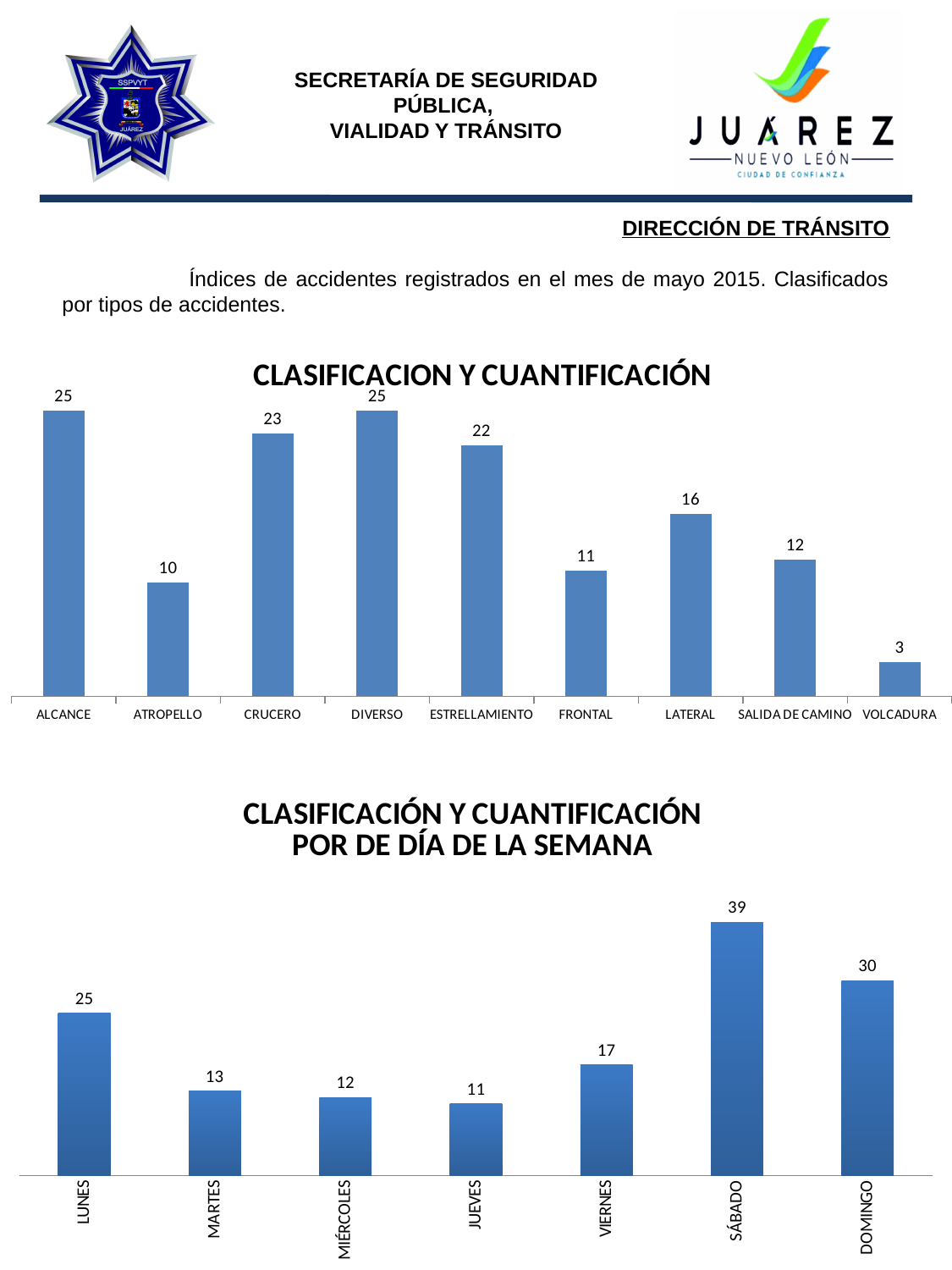
In the bottom chart (POR DE DÍA DE LA SEMANA), what is the difference between SÁBADO and DOMINGO? 9 In the bottom chart (POR DE DÍA DE LA SEMANA), what is the value for VIERNES? 17 In the bottom chart (POR DE DÍA DE LA SEMANA), which day has the lowest value? JUEVES How many categories are shown in the top chart (CLASIFICACION Y CUANTIFICACIÓN)? 9 In the top chart (CLASIFICACION Y CUANTIFICACIÓN), which category has the lowest value? VOLCADURA How many days are shown in the bottom chart (POR DE DÍA DE LA SEMANA)? 7 What type of chart is the bottom chart (POR DE DÍA DE LA SEMANA)? Bar chart In the top chart (CLASIFICACION Y CUANTIFICACIÓN), what is the value for LATERAL? 16 In the top chart (CLASIFICACION Y CUANTIFICACIÓN), what is the difference between ESTRELLAMIENTO and FRONTAL? 11 In the bottom chart (POR DE DÍA DE LA SEMANA), which day has the highest value? SÁBADO In the top chart (CLASIFICACION Y CUANTIFICACIÓN), what is the value for CRUCERO? 23 In the top chart (CLASIFICACION Y CUANTIFICACIÓN), which is larger, ATROPELLO or SALIDA DE CAMINO? SALIDA DE CAMINO